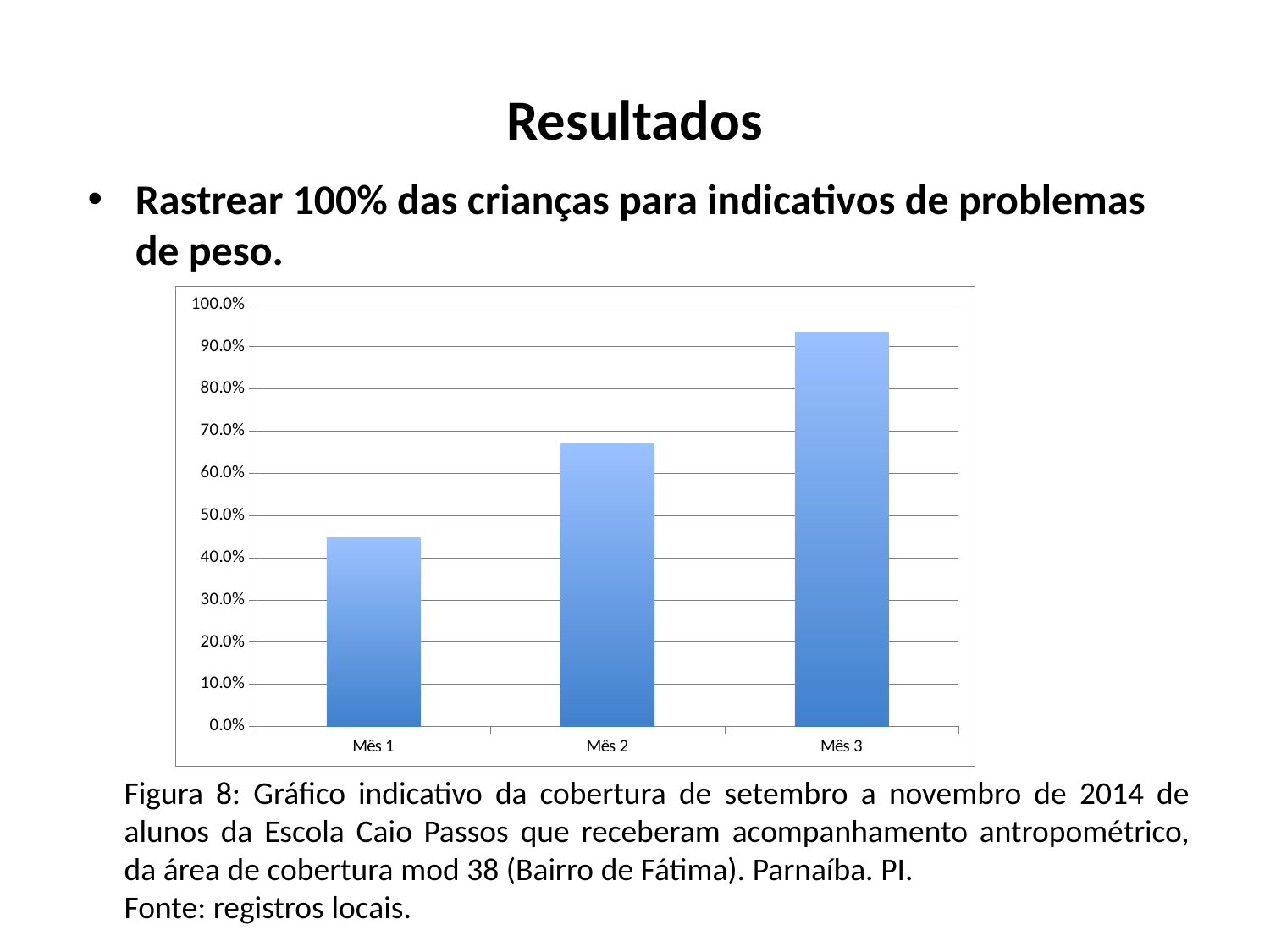
What is the maximum value shown on the y axis of the chart? 100.0% What is the label of the first category on the x axis? Mês 1 Which month has the highest bar in the chart? Mês 3 Is the value for Mês 2 greater or less than 60.0%? greater Which is larger, the value for Mês 1 or the value for Mês 2? Mês 2 Is the value for Mês 2 greater or less than 70.0%? less Which month has the lowest bar in the chart? Mês 1 What kind of chart is shown on the slide? bar chart How many categories are shown on the x axis of the chart? 3 Do the values rise or fall from Mês 1 to Mês 3? rise Is the value for Mês 3 greater or less than 90.0%? greater